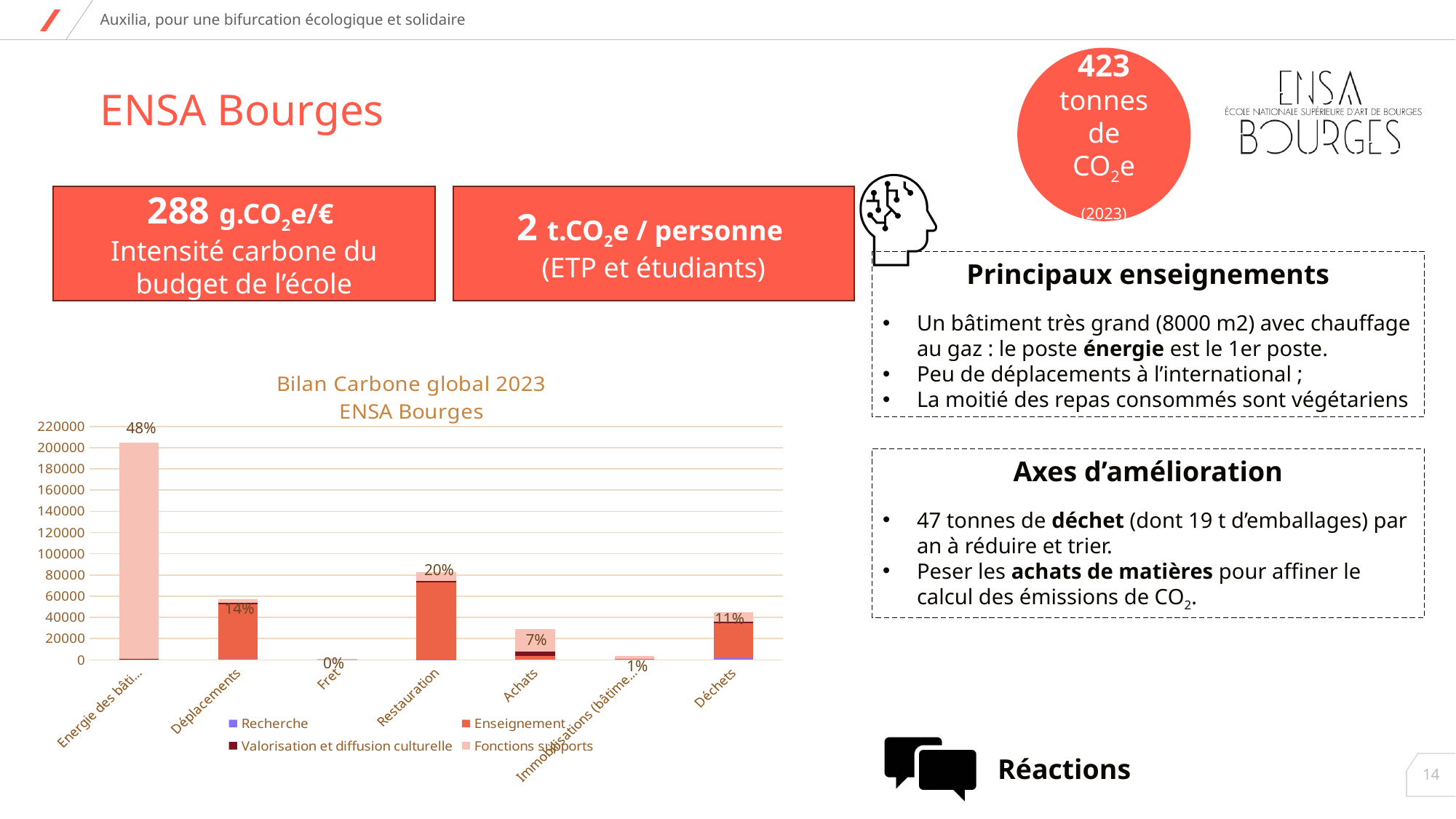
What kind of chart is shown on the slide? bar chart Is the total value for Energie des bâti... greater or less than 200000? greater What percentage label is shown for Déchets? 11% How many categories are shown on the x axis of the chart? 7 Which bar is taller, Restauration or Achats? Restauration What is the title of the chart? Bilan Carbone global 2023 ENSA Bourges What percentage label is shown above the Restauration bar? 20% How many series does the chart legend list? 4 What percentage label is shown for Achats? 7% What percentage label is shown for Déplacements? 14% Which category has the highest bar in the chart? Energie des bâti... Which category has the lowest bar, labelled 0%? Fret